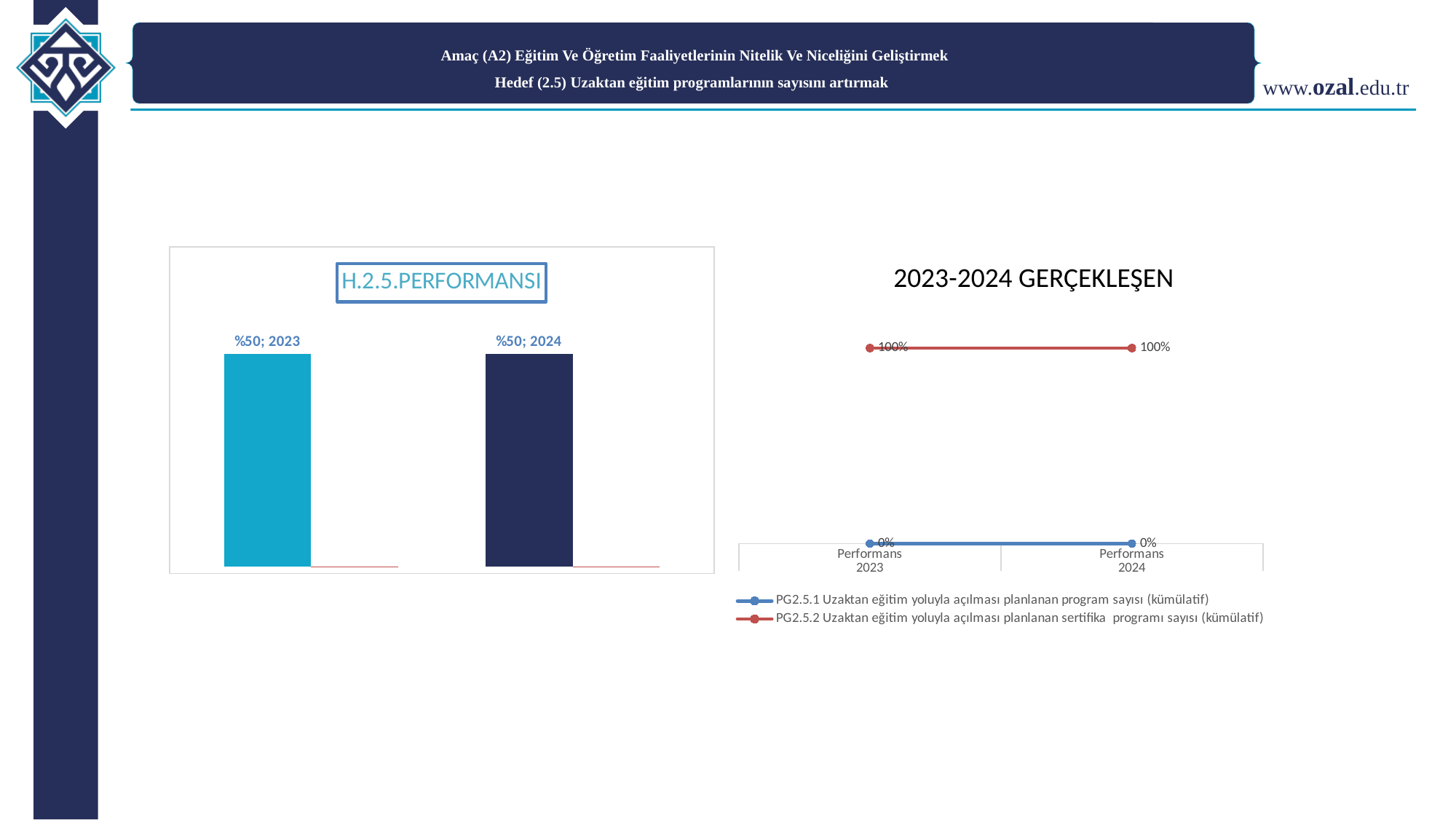
In the 2023-2024 GERÇEKLEŞEN chart, what colour is the line for PG2.5.1? blue In the H.2.5.PERFORMANSI chart, what is the difference between the 2023 and 2024 values? 0 In the H.2.5.PERFORMANSI chart, what is the value for 2023? %50 In the 2023-2024 GERÇEKLEŞEN chart, what is the value of PG2.5.1 for Performans 2024? 0% In the 2023-2024 GERÇEKLEŞEN chart, does the PG2.5.2 series rise, fall or stay flat from Performans 2023 to Performans 2024? stays flat In the 2023-2024 GERÇEKLEŞEN chart, what is the value of PG2.5.2 for Performans 2023? 100% What kind of chart is the 2023-2024 GERÇEKLEŞEN chart? line chart What kind of chart is the H.2.5.PERFORMANSI chart? bar chart In the H.2.5.PERFORMANSI chart, what is the value for 2024? %50 How many series does the legend of the 2023-2024 GERÇEKLEŞEN chart list? 2 In the 2023-2024 GERÇEKLEŞEN chart, which series has the higher value for Performans 2024, PG2.5.1 or PG2.5.2? PG2.5.2 How many bars are shown in the H.2.5.PERFORMANSI chart? 2